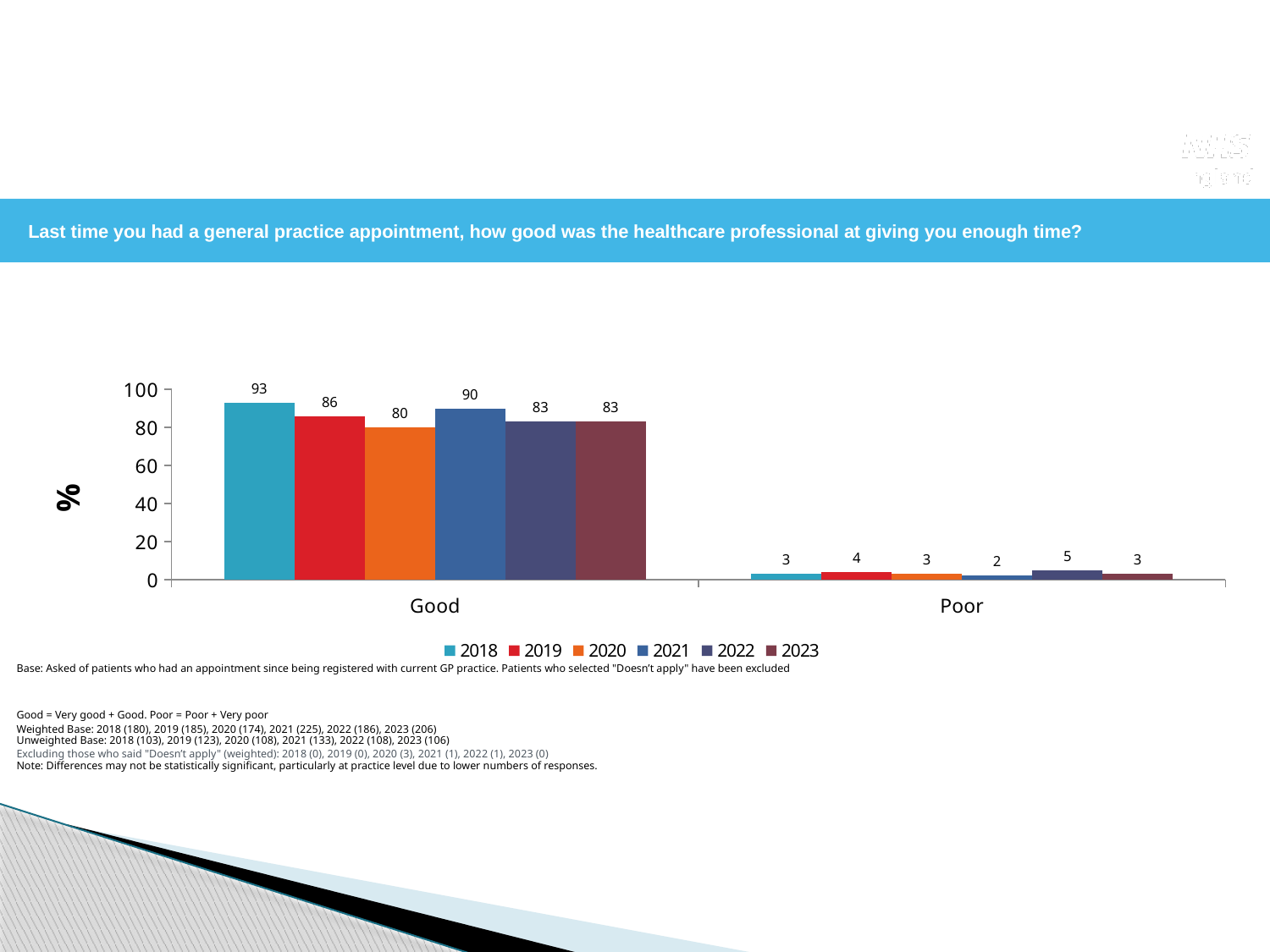
Which is larger in the Good category, the value for 2019 or the value for 2021? 2021 Which year has the highest value in the Poor category? 2022 What kind of chart is shown on the slide? Bar chart Which year has the lowest value in the Good category? 2020 How many categories are shown on the x axis? 2 What is the difference between the 2018 and 2023 values in the Good category? 10 Which year has the highest value in the Good category? 2018 How many series does the legend list? 6 What is the value for 2020 in the Good category? 80 What is the value for 2023 in the Poor category? 3 What is the label on the vertical axis? % What is the value for 2018 in the Good category? 93